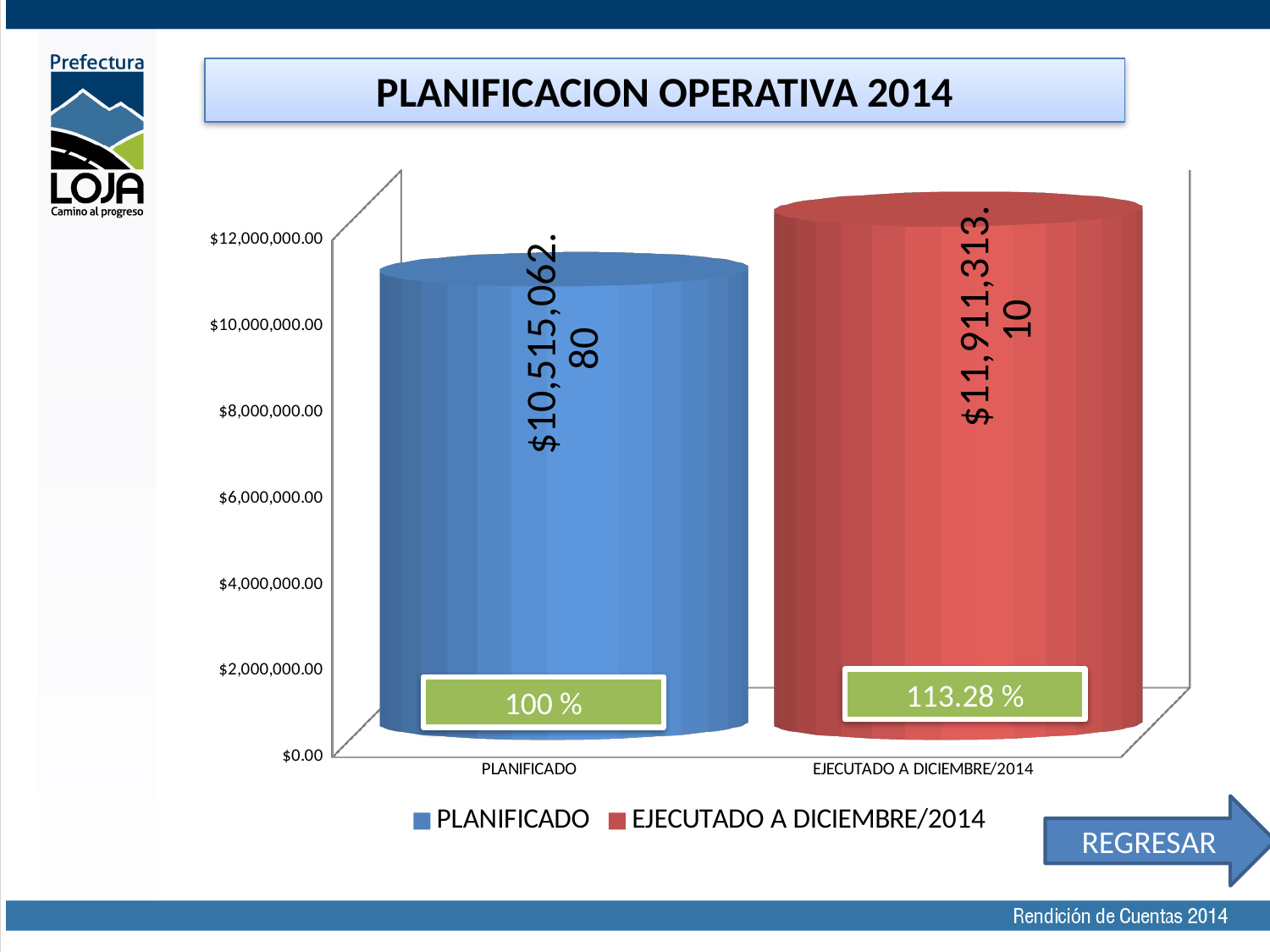
How many bars are plotted in the chart? 2 Which category has the highest value? EJECUTADO A DICIEMBRE/2014 What is the value for EJECUTADO A DICIEMBRE/2014? $11,911,313.10 What is the difference between the EJECUTADO A DICIEMBRE/2014 value and the PLANIFICADO value? $1,396,250.30 What percentage is shown on the PLANIFICADO bar? 100 % What is the value for PLANIFICADO? $10,515,062.80 Which category has the lowest value? PLANIFICADO Is the value for PLANIFICADO greater or less than $12,000,000.00? less How many entries does the legend list? 2 What percentage is shown on the EJECUTADO A DICIEMBRE/2014 bar? 113.28 % Which is larger, the value for PLANIFICADO or the value for EJECUTADO A DICIEMBRE/2014? EJECUTADO A DICIEMBRE/2014 What is the title of the chart? PLANIFICACION OPERATIVA 2014